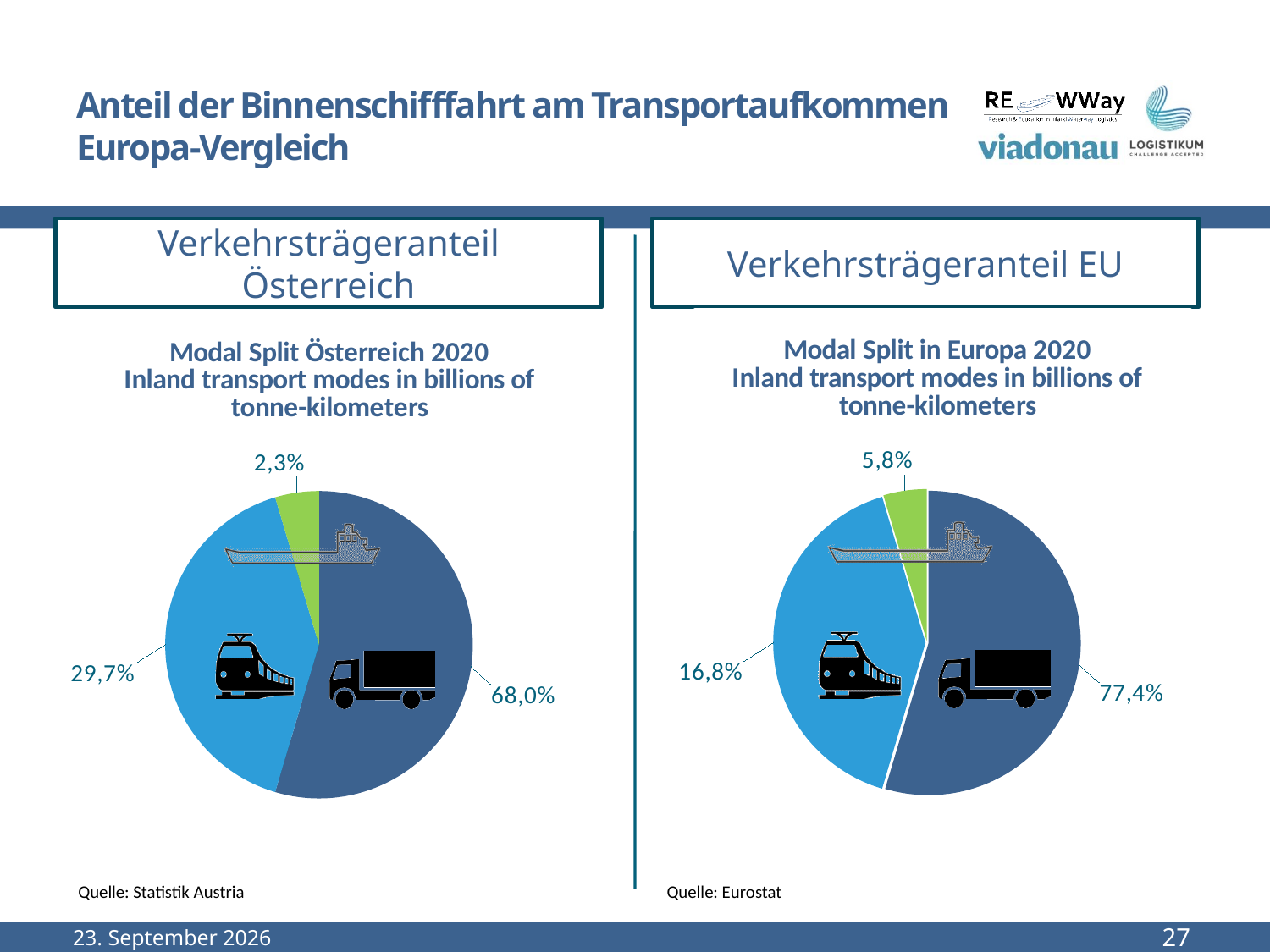
What is the difference between the largest slice in the "Modal Split in Europa 2020" chart (77,4%) and the largest slice in the "Modal Split Österreich 2020" chart (68,0%)? 9,4 percentage points In the "Modal Split in Europa 2020" chart, what share is shown for the largest slice (the one with the truck icon)? 77,4% Which is larger: the green (ship) slice in the "Modal Split Österreich 2020" chart or the green (ship) slice in the "Modal Split in Europa 2020" chart? Modal Split in Europa 2020 (5,8%) In the "Modal Split in Europa 2020" chart, what share is shown for the green slice (the one with the ship icon)? 5,8% In the "Modal Split Österreich 2020" chart, what share is shown for the largest slice (the one with the truck icon)? 68,0% What kind of chart is shown under the title "Modal Split Österreich 2020"? pie chart In the "Modal Split in Europa 2020" chart, what share is shown for the light blue slice (the one with the train icon)? 16,8% How many slices does the "Modal Split Österreich 2020" pie chart have? 3 In the "Modal Split Österreich 2020" chart, what share is shown for the green slice (the one with the ship icon)? 2,3% In the "Modal Split in Europa 2020" chart, which slice is the smallest? the green slice (ship), 5,8% What is the source given below the "Modal Split in Europa 2020" chart? Quelle: Eurostat In the "Modal Split Österreich 2020" chart, what share is shown for the light blue slice (the one with the train icon)? 29,7%